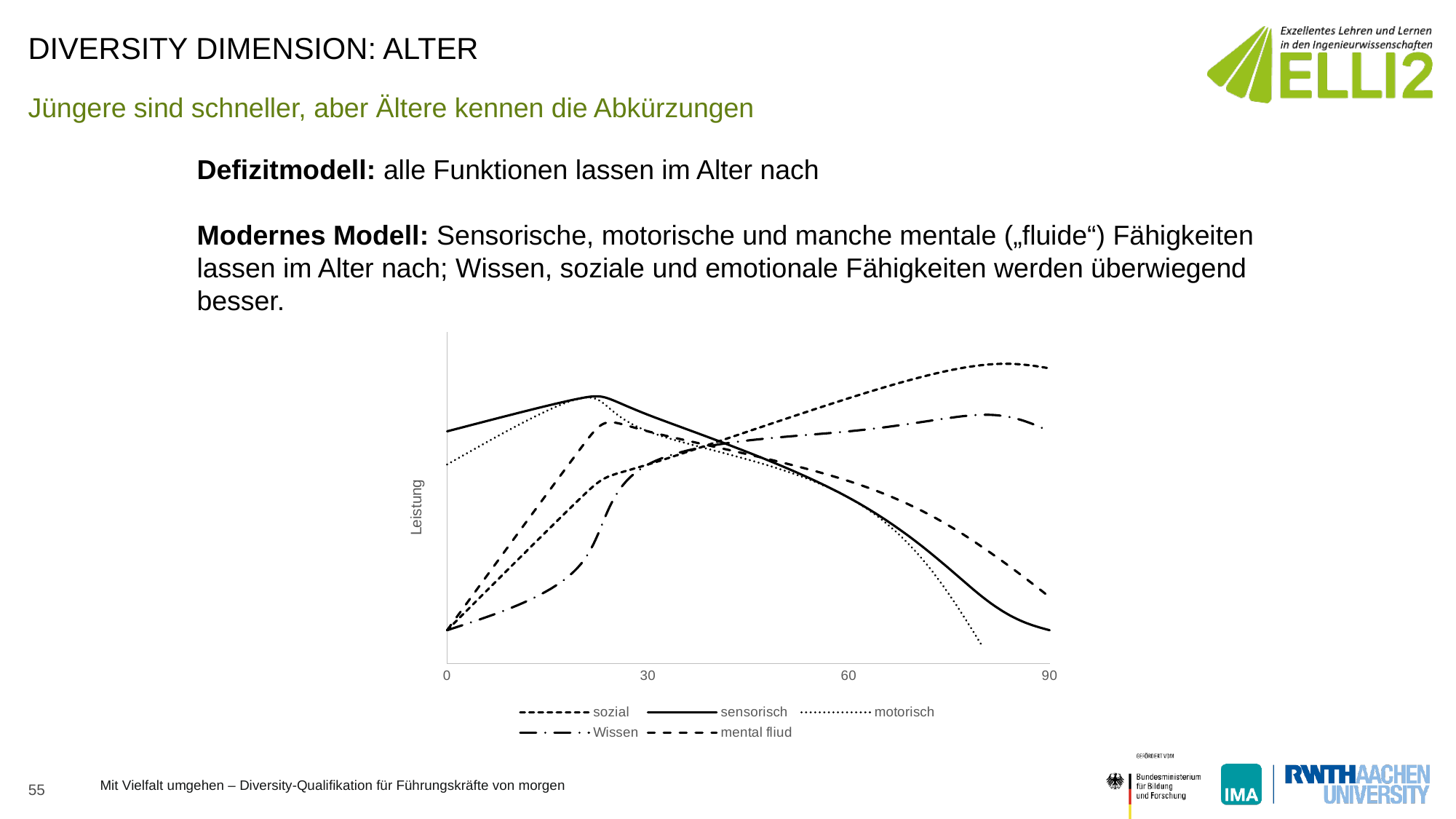
At age 90, which is larger: the value for sozial or the value for sensorisch? sozial At age 30, which is larger: the value for sensorisch or the value for Wissen? sensorisch At age 60, which is larger: the value for sozial or the value for mental fliud? sozial How many tick labels are shown on the chart's x axis? 4 Which series has the highest value at age 0? sensorisch Does the sensorisch series rise or fall between age 30 and age 90? falls Does the sozial series rise or fall overall along the x axis? rises Which series has the highest value at age 90? sozial How many series does the chart's legend list? 5 Which series are listed in the chart's legend? sozial, sensorisch, motorisch, Wissen, mental fliud What is the label of the chart's vertical axis? Leistung What kind of chart is shown on the slide? line chart